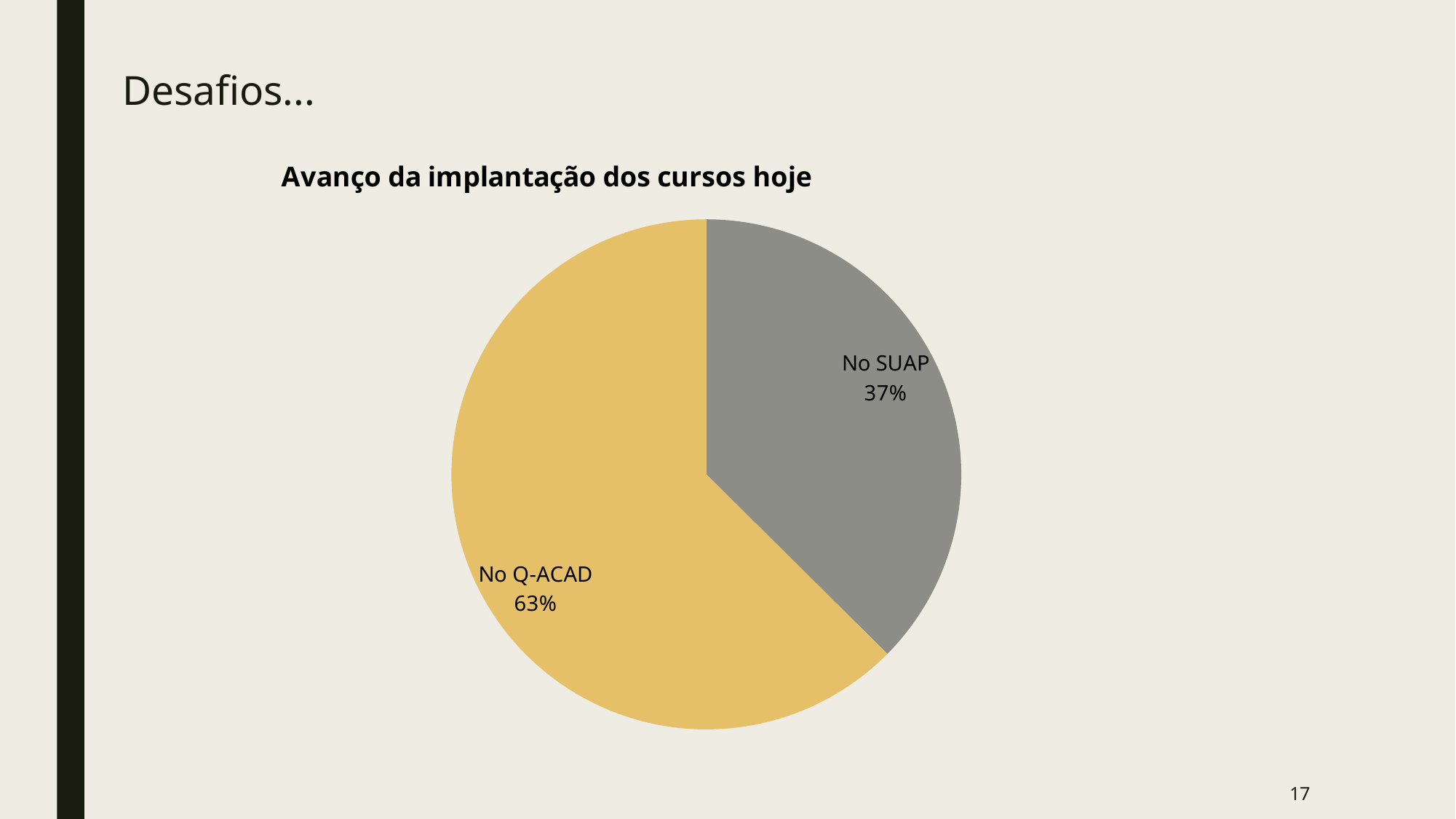
What is the title of the chart? Avanço da implantação dos cursos hoje What kind of chart is shown on the slide? pie chart What colour is the No SUAP slice? grey How many slices does the pie chart have? 2 Is the share for No Q-ACAD greater or less than 50%? greater What share of the pie does No SUAP represent? 37% Which is larger, the share for No SUAP or the share for No Q-ACAD? No Q-ACAD Which slice of the pie is the largest? No Q-ACAD What is the difference in percentage points between No Q-ACAD and No SUAP? 26 Which slice of the pie is the smallest? No SUAP What share of the pie does No Q-ACAD represent? 63%